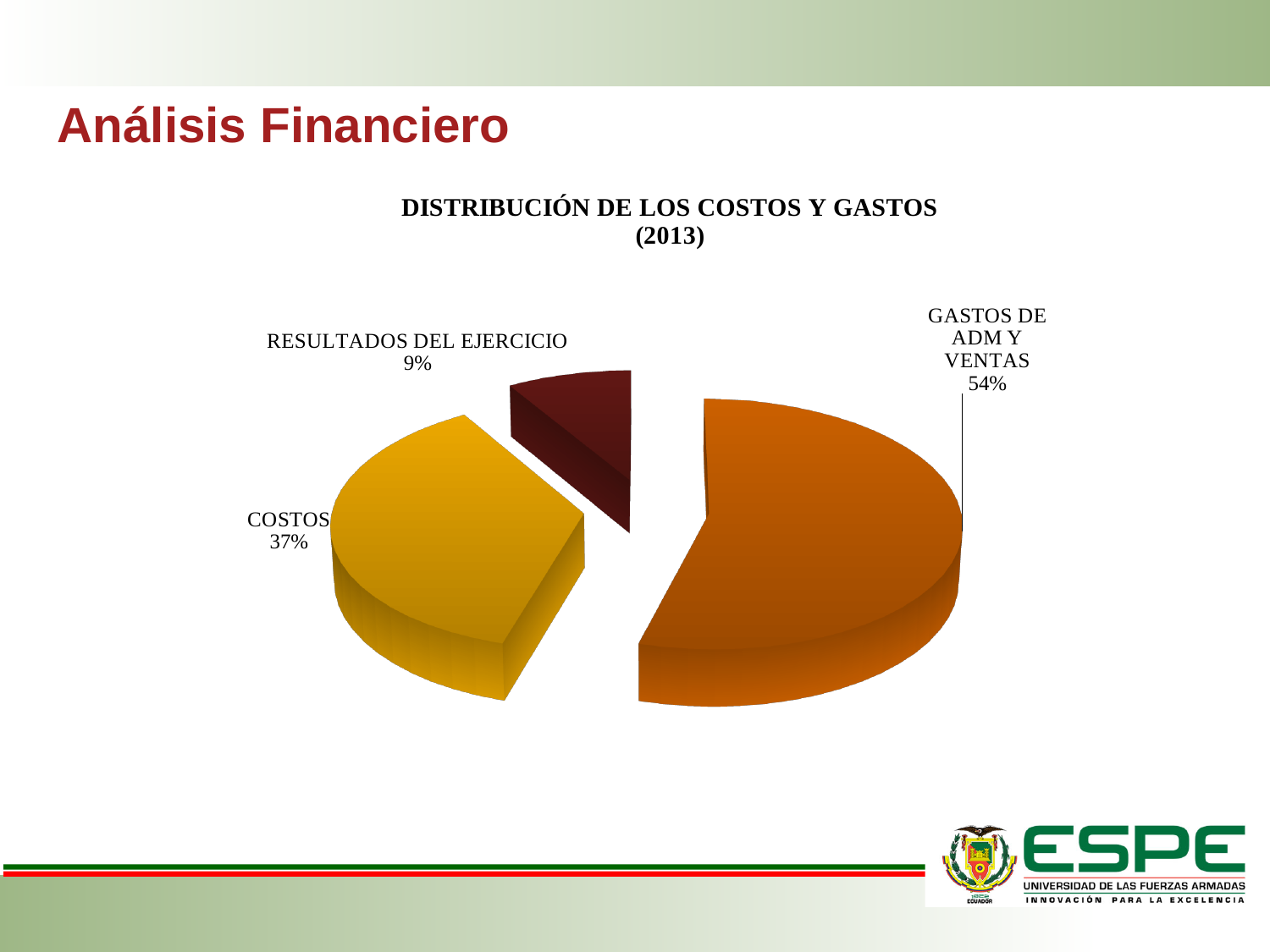
What share of the pie does GASTOS DE ADM Y VENTAS represent? 54% What share of the pie does COSTOS represent? 37% What is the difference in percentage points between COSTOS and RESULTADOS DEL EJERCICIO? 28 What is the difference in percentage points between GASTOS DE ADM Y VENTAS and COSTOS? 17 How many slices does the pie chart have? 3 What colour is the slice for COSTOS? Yellow What kind of chart is shown on the slide? Pie chart What is the title of the chart? DISTRIBUCIÓN DE LOS COSTOS Y GASTOS (2013) Which category has the smallest slice of the pie? RESULTADOS DEL EJERCICIO Which category has the largest slice of the pie? GASTOS DE ADM Y VENTAS What share of the pie does RESULTADOS DEL EJERCICIO represent? 9% Which is larger, the share for COSTOS or the share for RESULTADOS DEL EJERCICIO? COSTOS